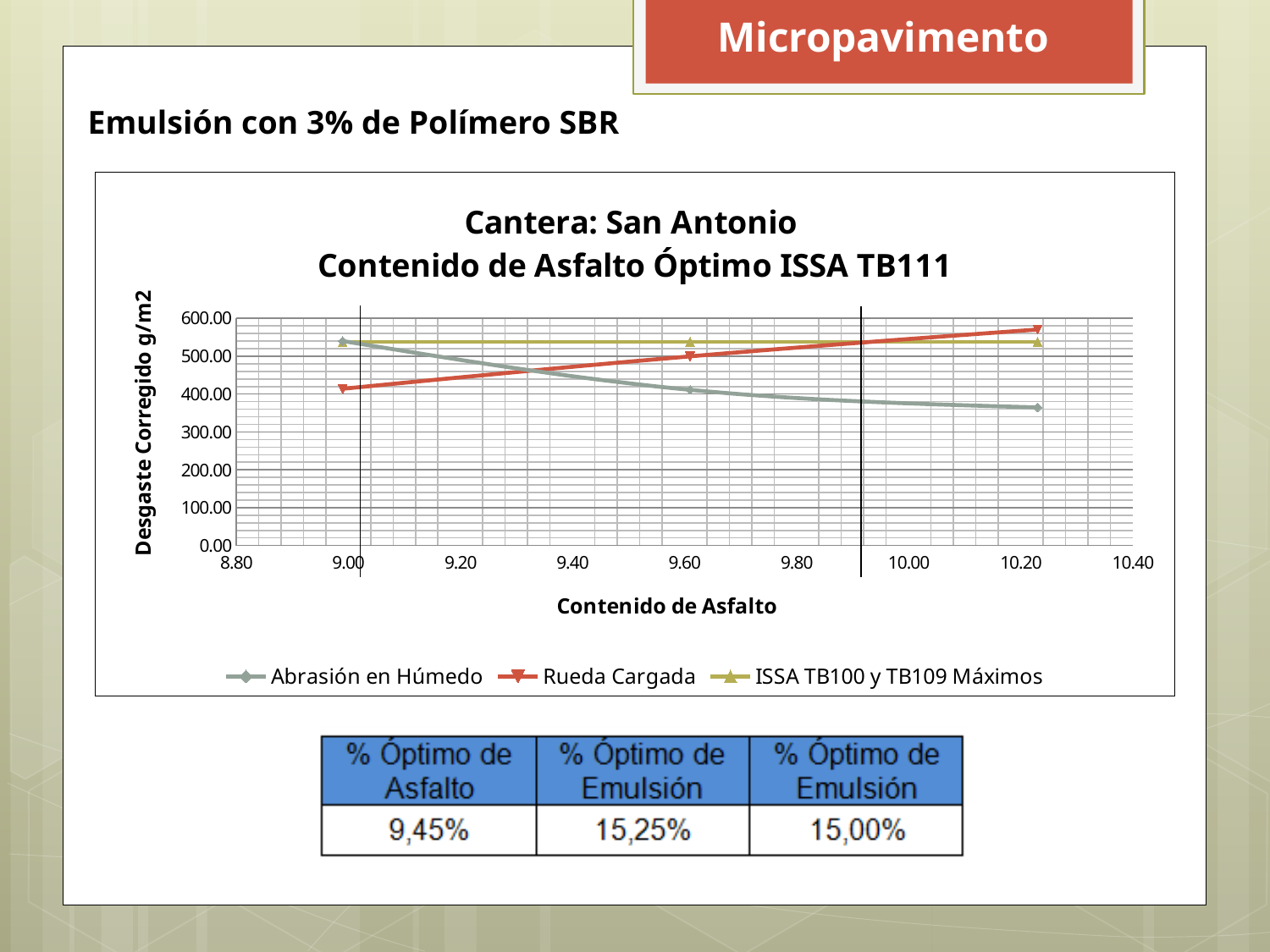
Is the Abrasión en Húmedo value at the lowest asphalt content (about 9.00) greater or less than 500.00? greater What is the title of the chart? Cantera: San Antonio Contenido de Asfalto Óptimo ISSA TB111 Is the Abrasión en Húmedo value at the highest asphalt content (about 10.20) greater or less than 400.00? less How many series does the chart legend list? 3 Is the Rueda Cargada value at the highest asphalt content (about 10.20) greater or less than 500.00? greater How many data points are plotted for the Abrasión en Húmedo series? 3 What kind of chart is shown on the slide? line chart At the highest asphalt content (about 10.20), which series has the larger value: Rueda Cargada or Abrasión en Húmedo? Rueda Cargada What is the label of the vertical axis of the chart? Desgaste Corregido g/m2 Does the Abrasión en Húmedo series rise or fall as Contenido de Asfalto increases? fall Does the Rueda Cargada series rise or fall as Contenido de Asfalto increases? rise